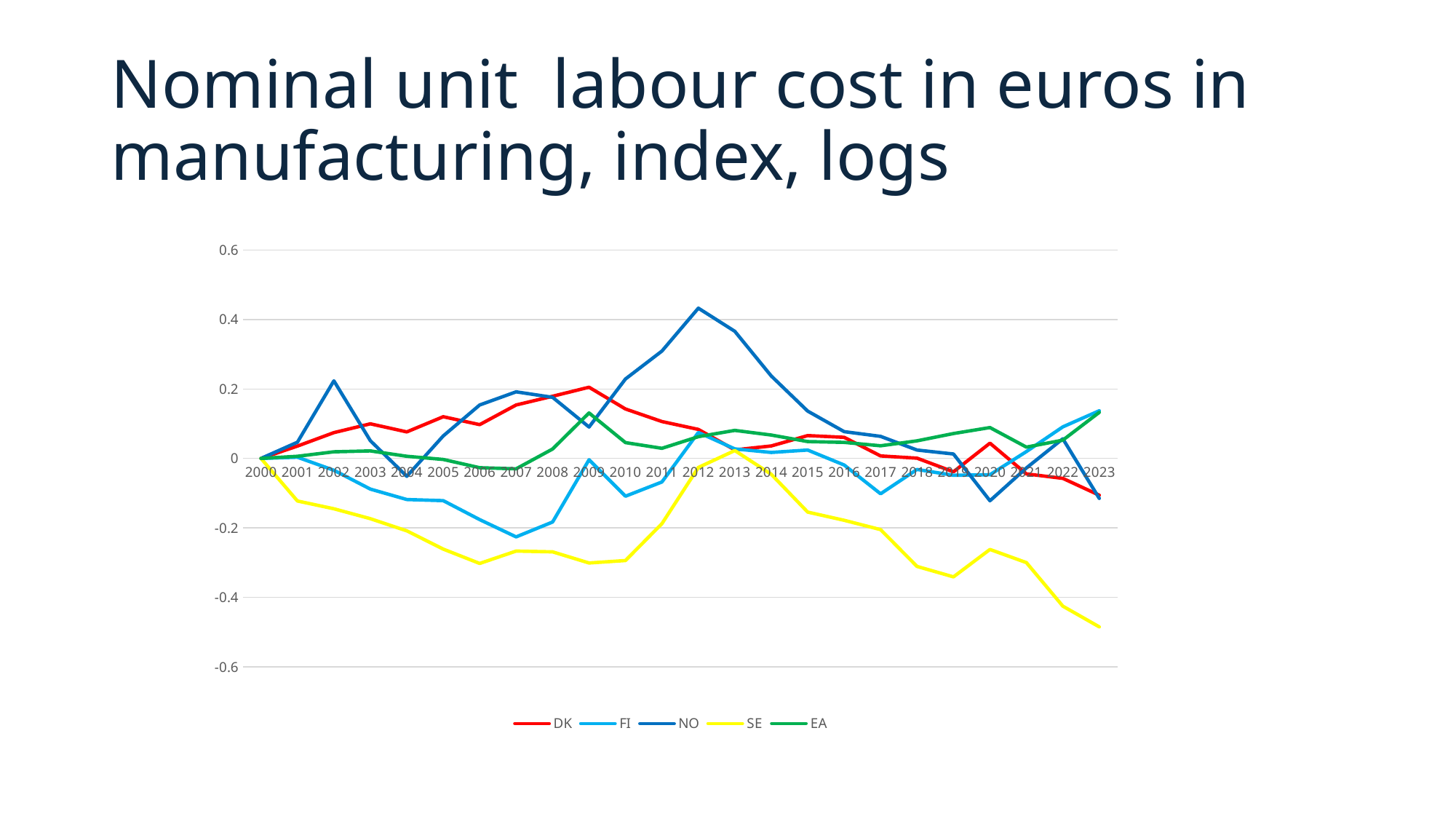
Is the value for SE in 2023 greater or less than -0.4? less How many years are plotted along the x axis? 24 Is the value for SE in 2006 greater or less than -0.2? less Is the value for NO in 2013 greater or less than 0.2? greater How many series does the legend list? 5 Which is larger in 2012, the value for NO or the value for DK? NO What colour is the SE series line? yellow Which series has the highest value in 2012? NO What kind of chart is shown on the slide? line chart Which series has the lowest value in 2023? SE Does the SE series rise or fall overall from 2000 to 2023? fall